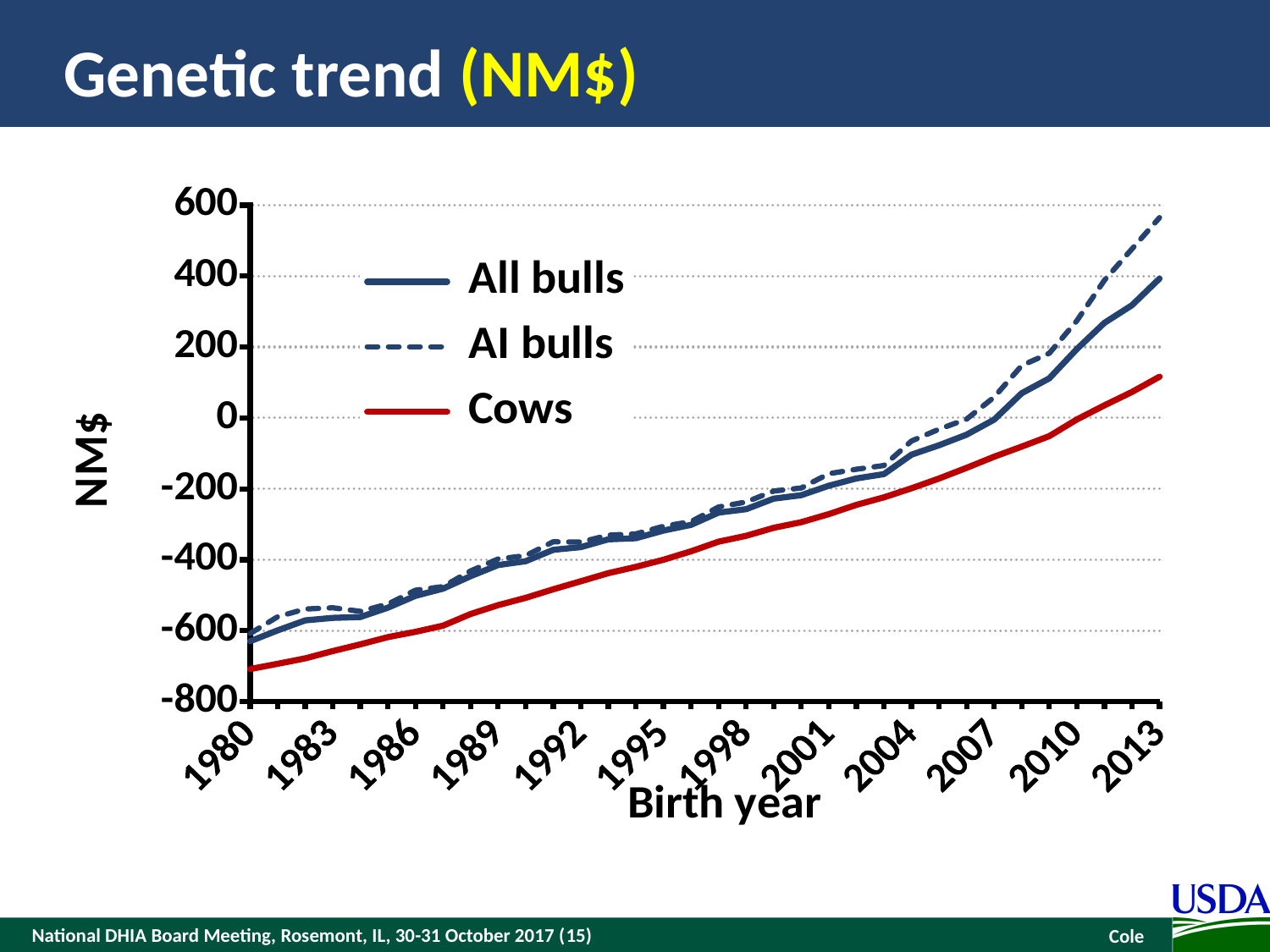
Is the value for Cows in 1980 greater or less than -600? less How many series does the legend list? 3 In 1980, which is larger, the value for All bulls or the value for Cows? All bulls Is the value for Cows in 2013 greater or less than 0? greater Do the values for AI bulls rise or fall along the x axis? rise Is the value for Cows in 2007 greater or less than 0? less What is the label of the x axis? Birth year What are the three series named in the legend? All bulls, AI bulls, Cows What kind of chart is shown on the slide? line chart Do the values for Cows rise or fall as birth year increases from 1980 to 2013? rise Which series has the highest value in 2013? AI bulls